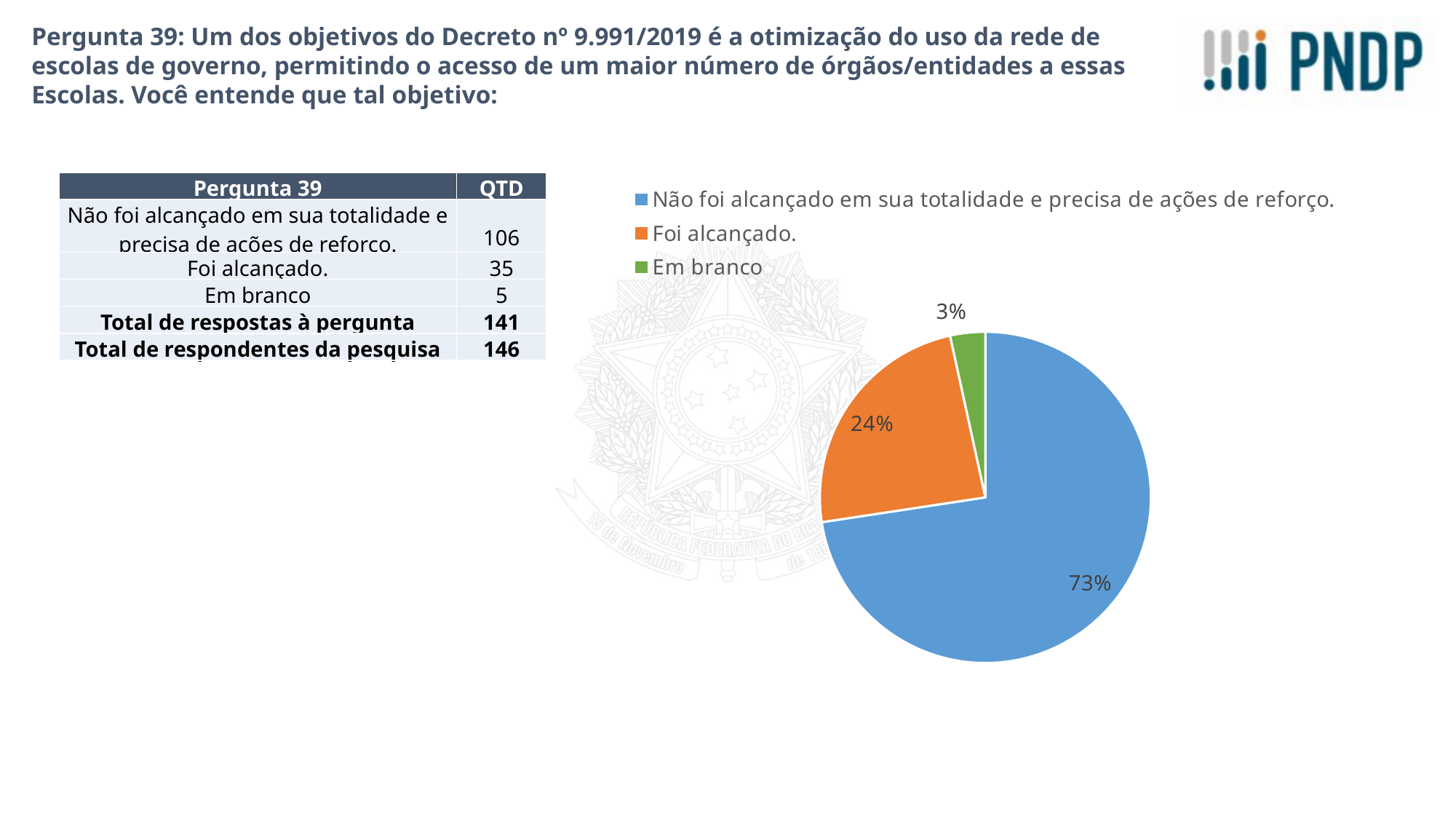
What kind of chart is shown on the slide? pie chart What share of the pie does the slice "Foi alcançado." represent? 24% What is the difference in percentage points between the "Não foi alcançado em sua totalidade e precisa de ações de reforço." slice and the "Foi alcançado." slice? 49 percentage points Which slice is larger, "Foi alcançado." or "Em branco"? Foi alcançado. What colour is the "Foi alcançado." slice in the pie chart? orange How many entries does the legend of the pie chart list? 3 How many slices does the pie chart have? 3 Which slice of the pie chart is the largest? Não foi alcançado em sua totalidade e precisa de ações de reforço. What share of the pie does the slice "Em branco" represent? 3% What share of the pie does the slice "Não foi alcançado em sua totalidade e precisa de ações de reforço." represent? 73% What colour is the "Em branco" slice in the pie chart? green Which slice of the pie chart is the smallest? Em branco